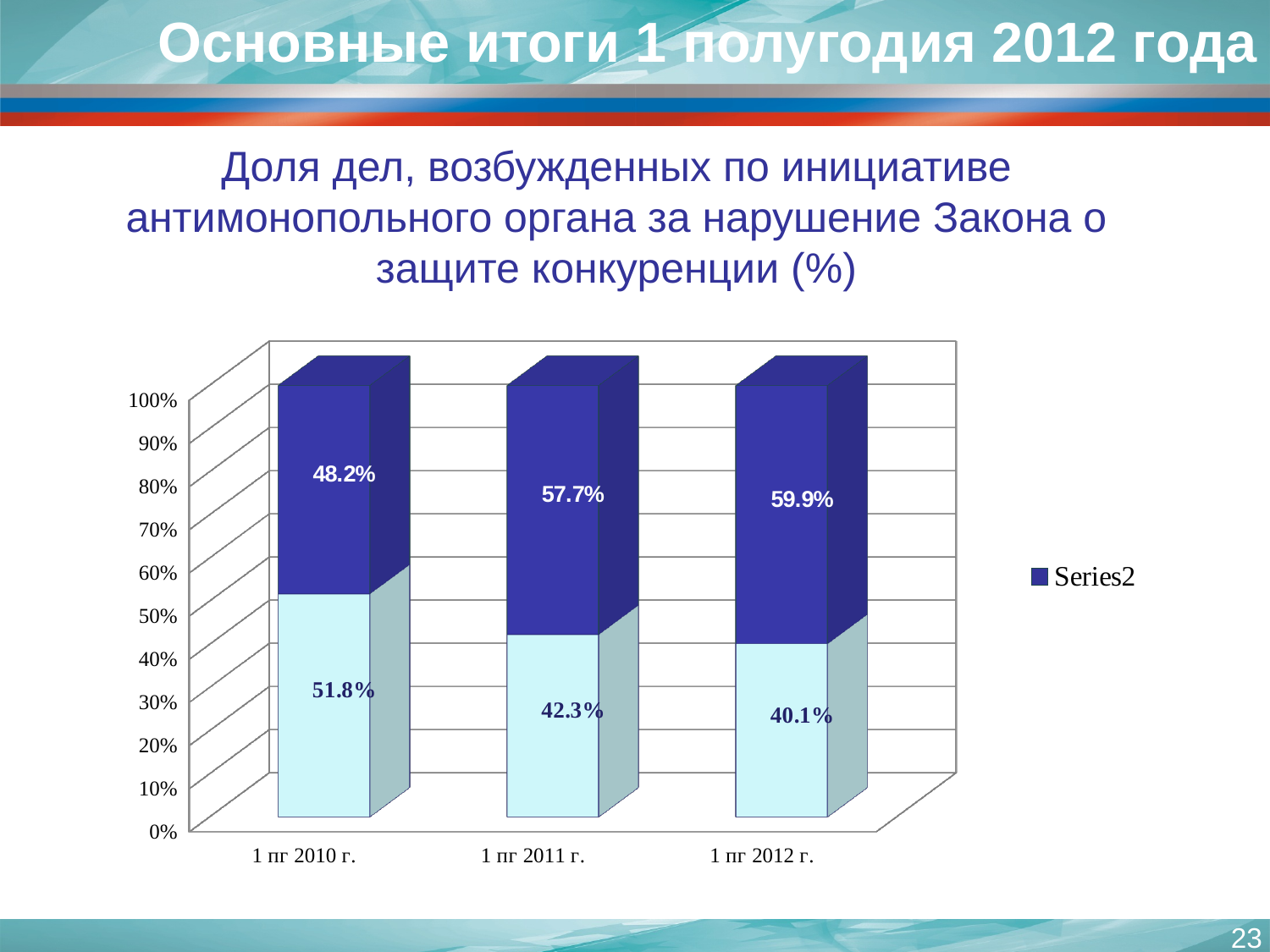
What is the difference between the dark blue (Series2) values for 1 пг 2012 г. and 1 пг 2010 г.? 11.7% What is the value of the dark blue (Series2) segment for 1 пг 2012 г.? 59.9% What kind of chart is shown on the slide? stacked bar chart What is the value of the light blue bottom segment for 1 пг 2012 г.? 40.1% Does the dark blue (Series2) value rise or fall from 1 пг 2010 г. to 1 пг 2012 г.? rise How many series does the legend list? 1 How many periods are shown on the x axis? 3 In which period is the light blue bottom segment the smallest? 1 пг 2012 г. Which is larger for 1 пг 2010 г.: the light blue bottom segment or the dark blue (Series2) segment? the light blue bottom segment In which period is the dark blue (Series2) segment the largest? 1 пг 2012 г. What is the value of the light blue bottom segment for 1 пг 2010 г.? 51.8% What is the value of the dark blue (Series2) segment for 1 пг 2011 г.? 57.7%